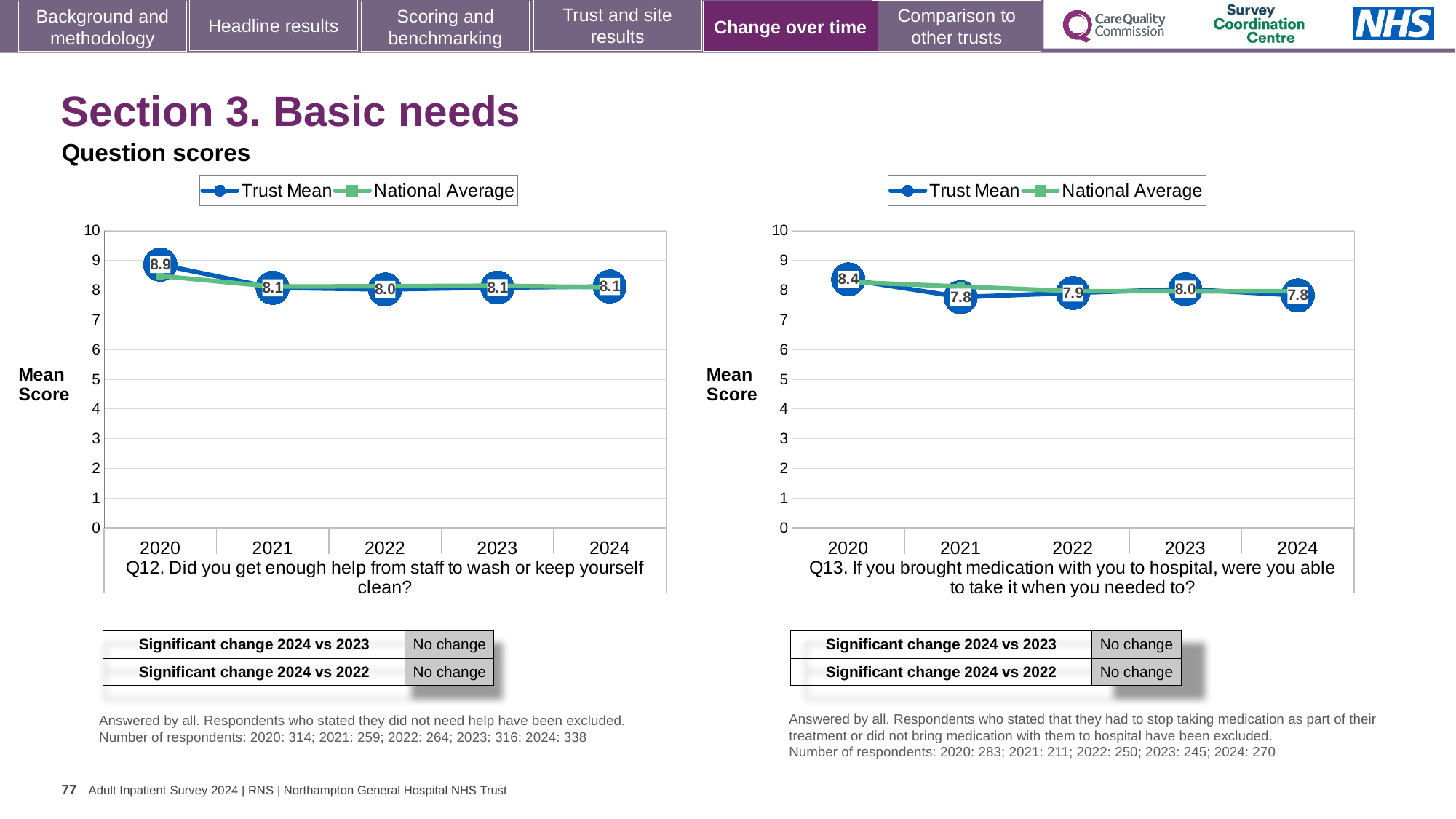
In the Q12 chart (left), what is the difference between the Trust Mean scores for 2020 and 2024? 0.8 How many series does the legend of the Q13 chart (right) list? 2 In the Q13 chart (right), what is the difference between the Trust Mean scores for 2020 and 2021? 0.6 In the Q13 chart (right), is the Trust Mean score for 2020 larger or smaller than the score for 2022? larger How many years are plotted on the x axis of the Q12 chart (left)? 5 In the Q13 chart (right), what is the Trust Mean score for 2023? 8.0 In the Q12 chart (left), which year has the highest Trust Mean score? 2020 In the Q12 chart (left), what is the Trust Mean score for 2022? 8.0 What kind of chart is the Q12 chart (left)? Line chart In the Q13 chart (right), what is the Trust Mean score for 2024? 7.8 In the Q13 chart (right), which year has the highest Trust Mean score? 2020 In the Q12 chart (left), what is the Trust Mean score for 2020? 8.9